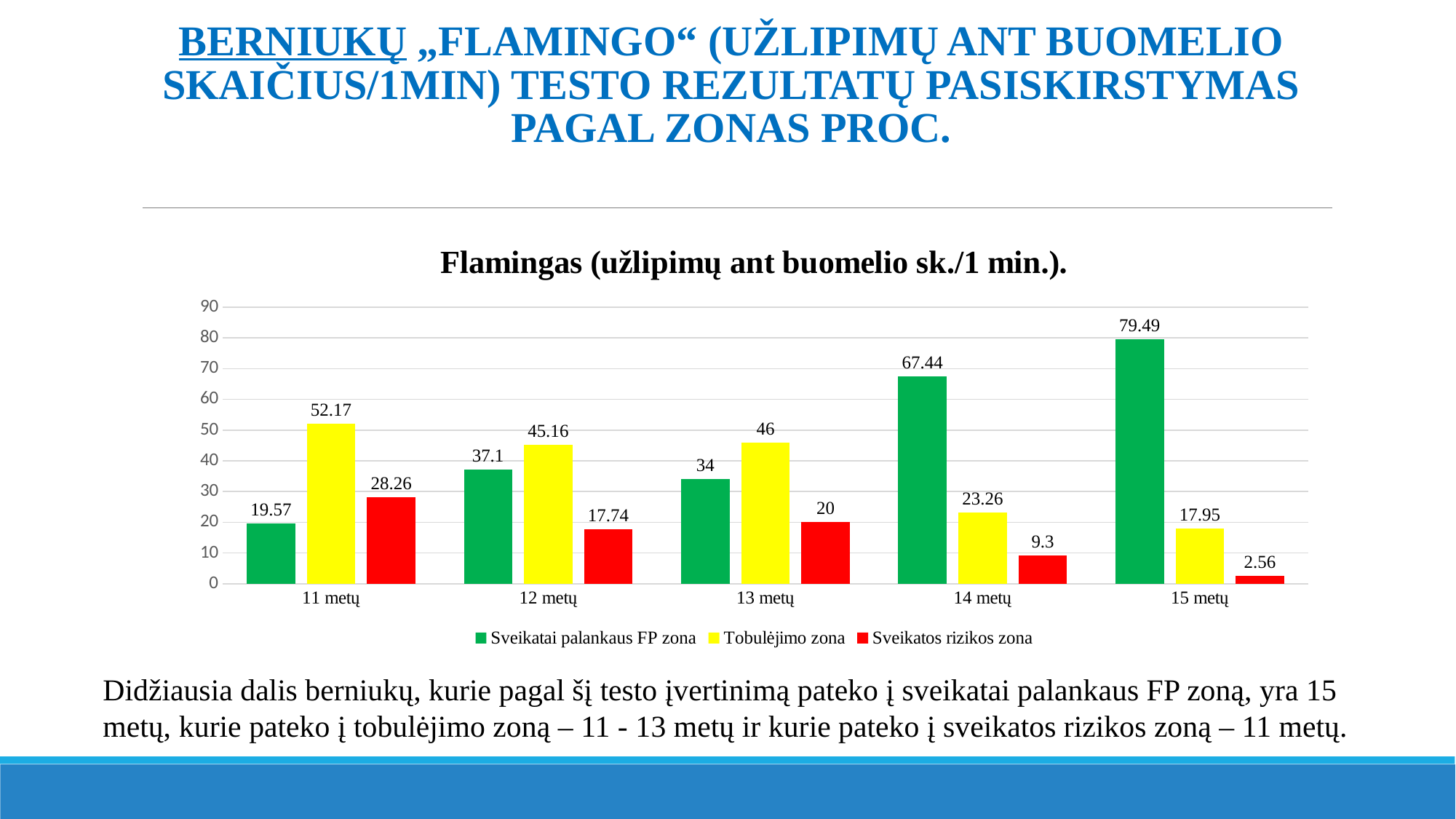
How many series does the legend list? 3 Which age group has the highest value for Sveikatos rizikos zona? 11 metų Which is larger at 12 metų: Sveikatai palankaus FP zona or Tobulėjimo zona? Tobulėjimo zona Which age group has the lowest value for Sveikatai palankaus FP zona? 11 metų Do the values for Sveikatos rizikos zona rise or fall from 11 metų to 15 metų? Fall How many age groups are shown on the x axis? 5 What is the value for Sveikatai palankaus FP zona at 15 metų? 79.49 What is the value for Sveikatos rizikos zona at 13 metų? 20 What colour represents Tobulėjimo zona in the chart? Yellow What is the value for Tobulėjimo zona at 11 metų? 52.17 What is the difference between the Sveikatai palankaus FP zona values for 15 metų and 14 metų? 12.05 What kind of chart is shown on the slide? Bar chart